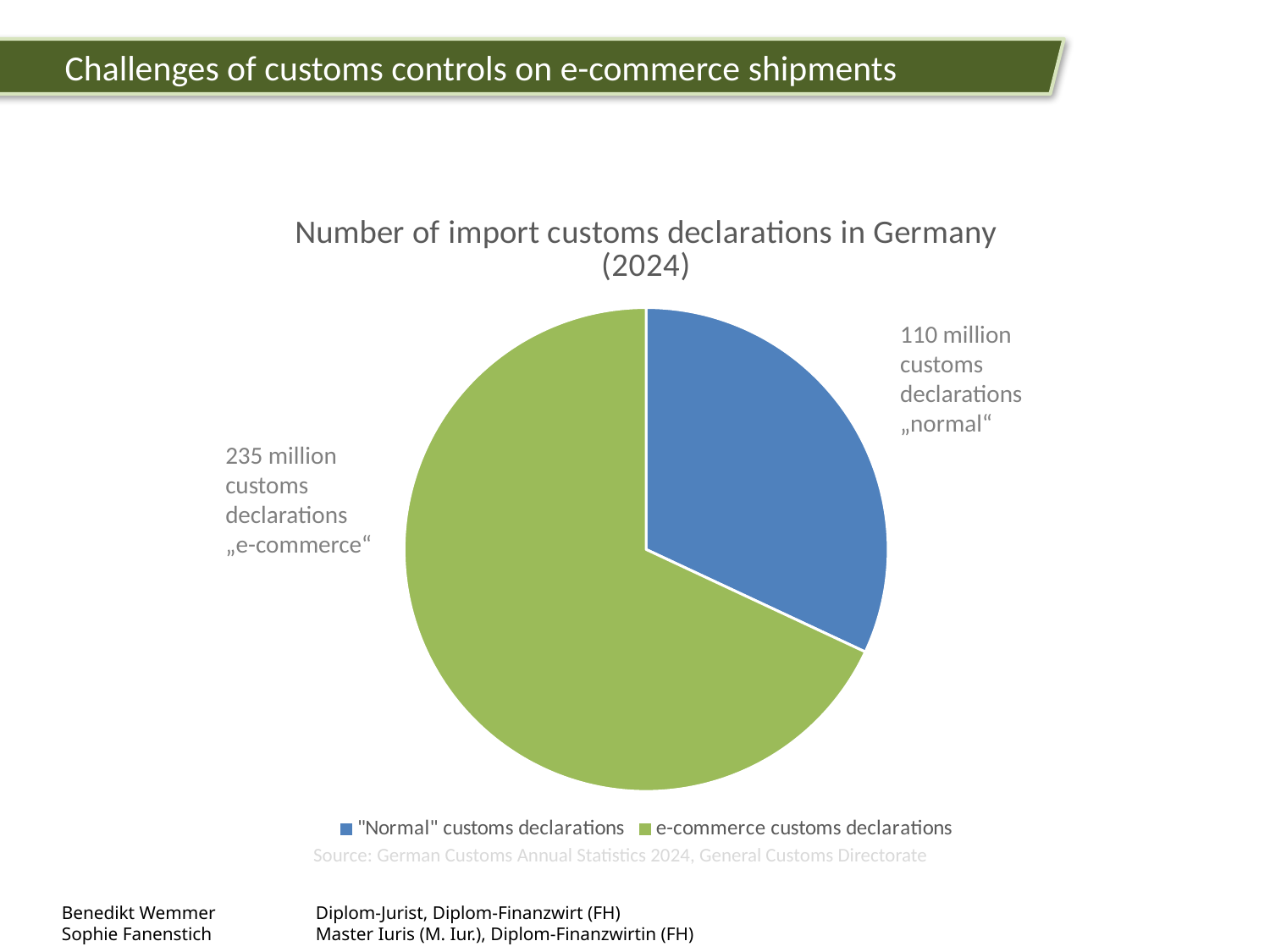
Are there more "normal" customs declarations or e-commerce customs declarations? e-commerce customs declarations What type of chart is shown on the slide? Pie chart Which category has the smaller number of customs declarations? "Normal" customs declarations How many slices does the pie chart have? 2 What is the total number of import customs declarations shown in the chart? 345 million Which category has the larger number of customs declarations? e-commerce customs declarations Which colour represents e-commerce customs declarations in the pie chart? Green By how many million do e-commerce customs declarations exceed "normal" customs declarations? 125 million How many entries does the legend list? 2 How many e-commerce customs declarations are shown in the chart? 235 million How many "normal" customs declarations are shown in the chart? 110 million What is the title of the chart? Number of import customs declarations in Germany (2024)